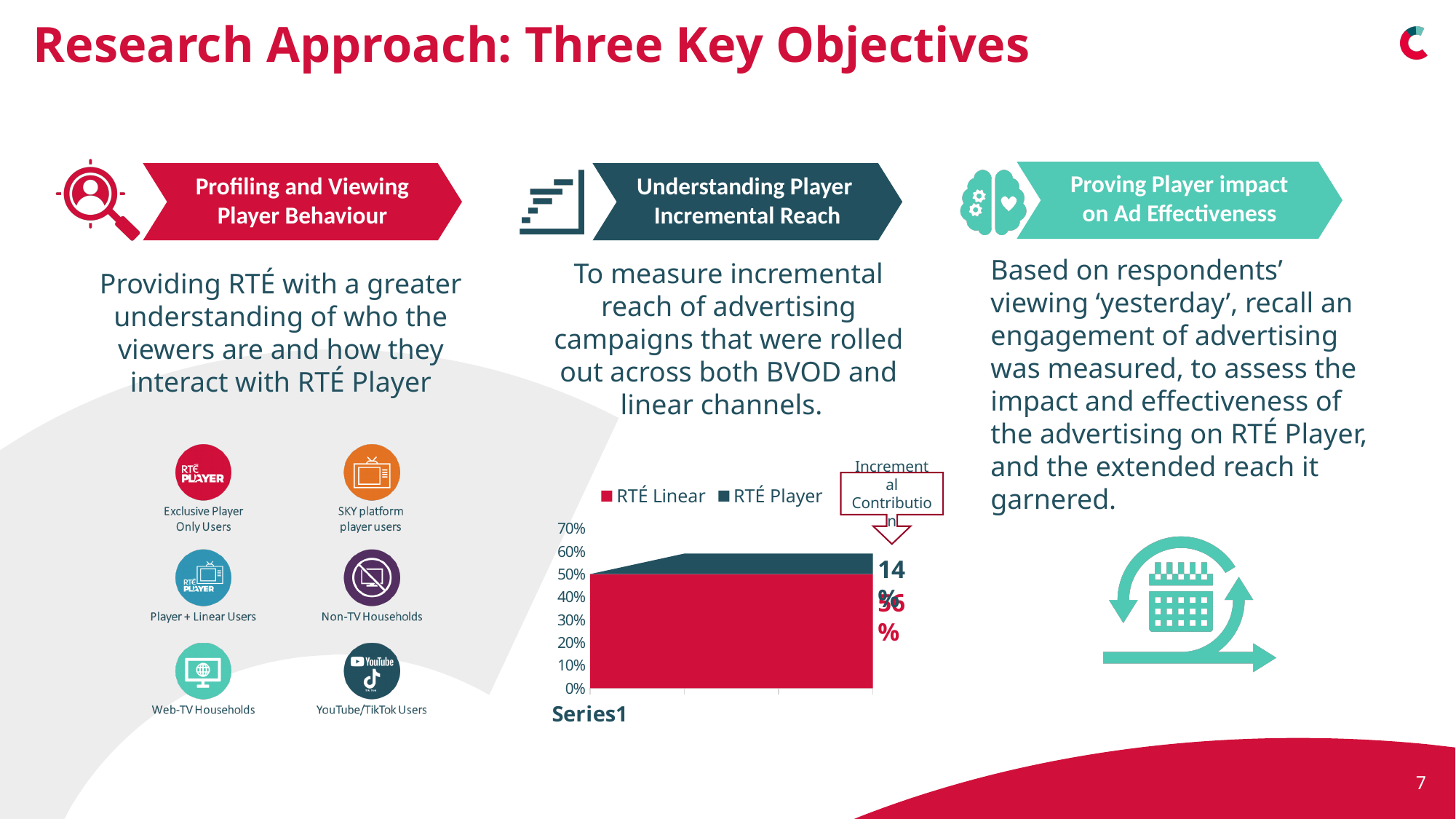
What value is labelled for the RTÉ Player segment of the bar chart? 14% What kind of chart is shown under the 'Understanding Player Incremental Reach' objective? Area chart Is the value for RTÉ Linear in the bar chart greater or less than 40%? greater In the bar chart, which series has the larger value, RTÉ Linear or RTÉ Player? RTÉ Linear Is the value for RTÉ Player in the bar chart greater or less than 20%? less Which series forms the largest part of the stacked bar in the chart? RTÉ Linear What is the highest value shown on the y axis of the bar chart? 70% Which series forms the smallest part of the stacked bar in the chart? RTÉ Player What does the callout arrow above the bar chart say? Incremental Contribution How many series does the legend of the bar chart list? 2 What are the two series named in the bar chart's legend? RTÉ Linear and RTÉ Player